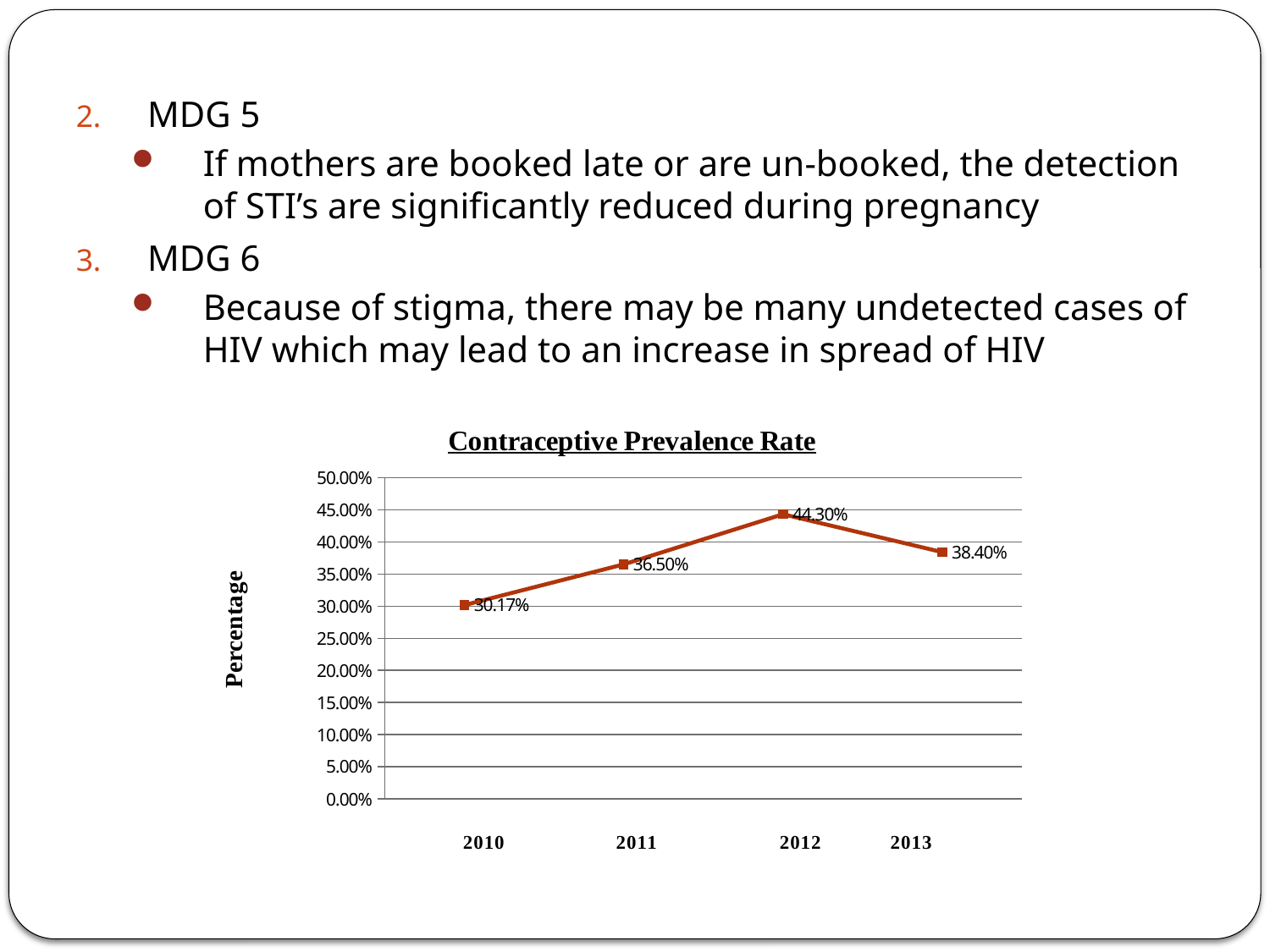
How many years are plotted on the chart? 4 Is the contraceptive prevalence rate for 2011 greater or less than 35.00%? greater What is the title of the chart? Contraceptive Prevalence Rate What kind of chart is shown on the slide? line chart Which year has a higher contraceptive prevalence rate, 2011 or 2013? 2013 What is the difference between the contraceptive prevalence rate in 2012 and in 2011? 7.80% Does the contraceptive prevalence rate rise or fall from 2012 to 2013? fall Which year has the lowest contraceptive prevalence rate? 2010 What is the contraceptive prevalence rate for 2012? 44.30% What is the contraceptive prevalence rate for 2010? 30.17% What is the contraceptive prevalence rate for 2013? 38.40% Which year has the highest contraceptive prevalence rate? 2012